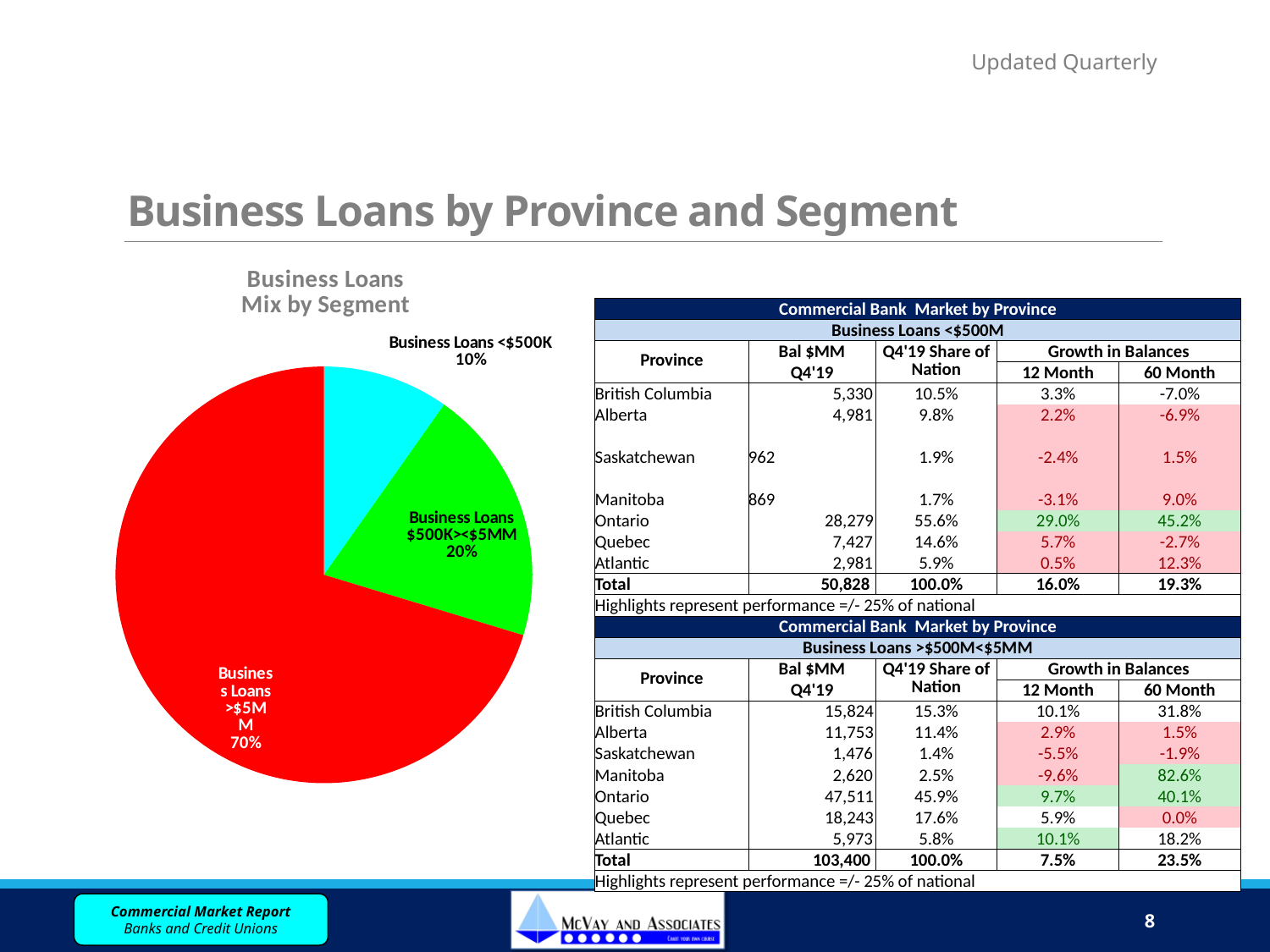
Which segment has the smallest slice of the pie chart? Business Loans <$500K What is the combined share of the Business Loans <$500K and Business Loans $500K><$5MM slices? 30% How many slices does the pie chart have? 3 What is the title of the pie chart? Business Loans Mix by Segment What colour is the Business Loans >$5MM slice in the pie chart? Red Which slice is larger: Business Loans <$500K or Business Loans $500K><$5MM? Business Loans $500K><$5MM What share of the pie does Business Loans $500K><$5MM represent? 20% What is the difference in percentage points between the Business Loans >$5MM slice and the Business Loans $500K><$5MM slice? 50 percentage points What share of the pie does Business Loans >$5MM represent? 70% What kind of chart is shown on the slide? Pie chart Which segment has the largest slice of the pie chart? Business Loans >$5MM What share of the pie does Business Loans <$500K represent? 10%